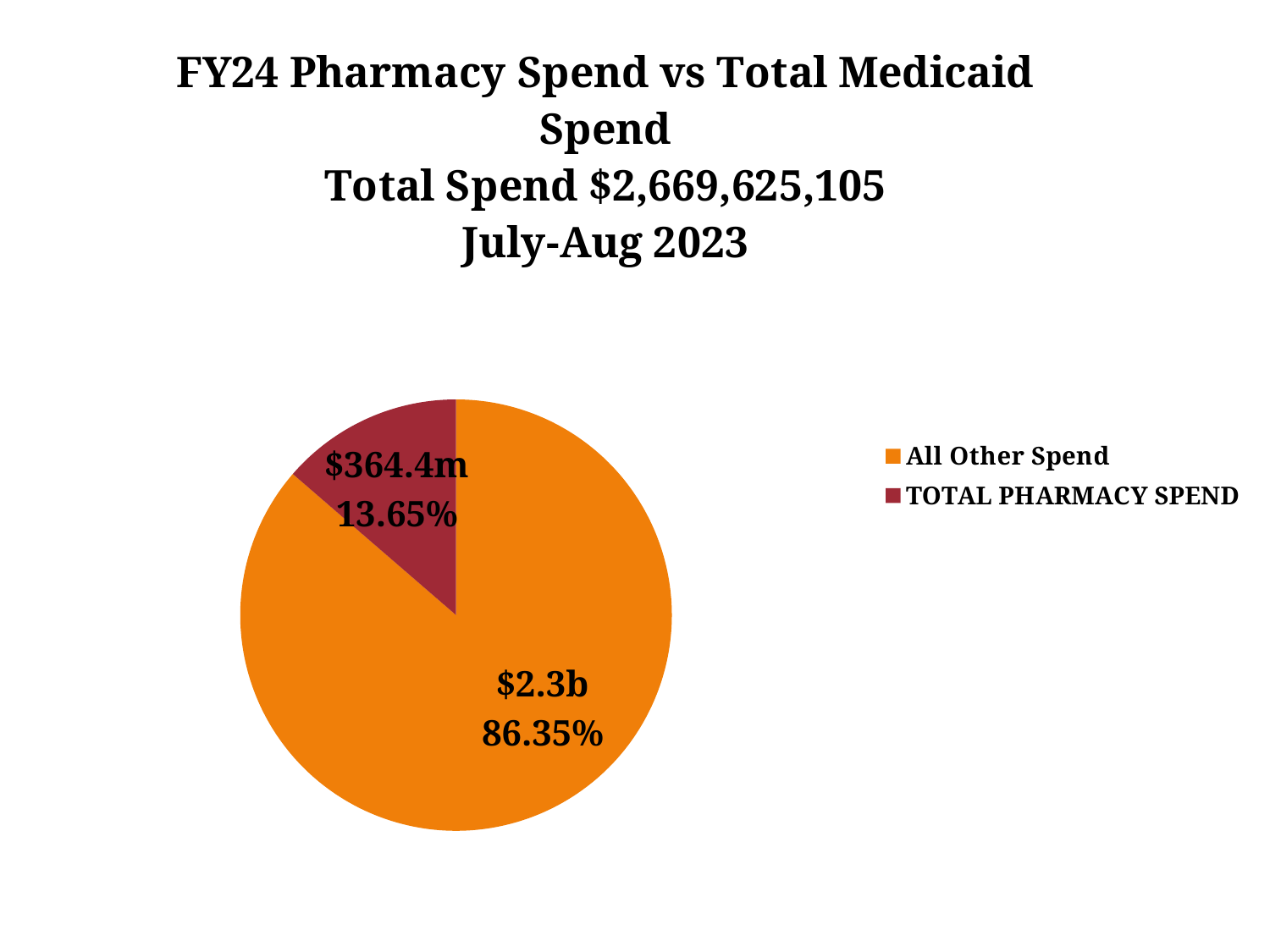
What kind of chart is shown on the slide? Pie chart What share of the pie does All Other Spend represent? 86.35% What total spend is stated in the chart title? $2,669,625,105 What share of the pie does TOTAL PHARMACY SPEND represent? 13.65% How many slices does the pie chart have? 2 What is the value shown for TOTAL PHARMACY SPEND? $364.4m What is the difference in percentage points between the All Other Spend share and the TOTAL PHARMACY SPEND share? 72.7 percentage points Which slice is the smallest? TOTAL PHARMACY SPEND Which is larger, All Other Spend or TOTAL PHARMACY SPEND? All Other Spend How many entries does the legend list? 2 Which slice is the largest? All Other Spend What is the value shown for All Other Spend? $2.3b